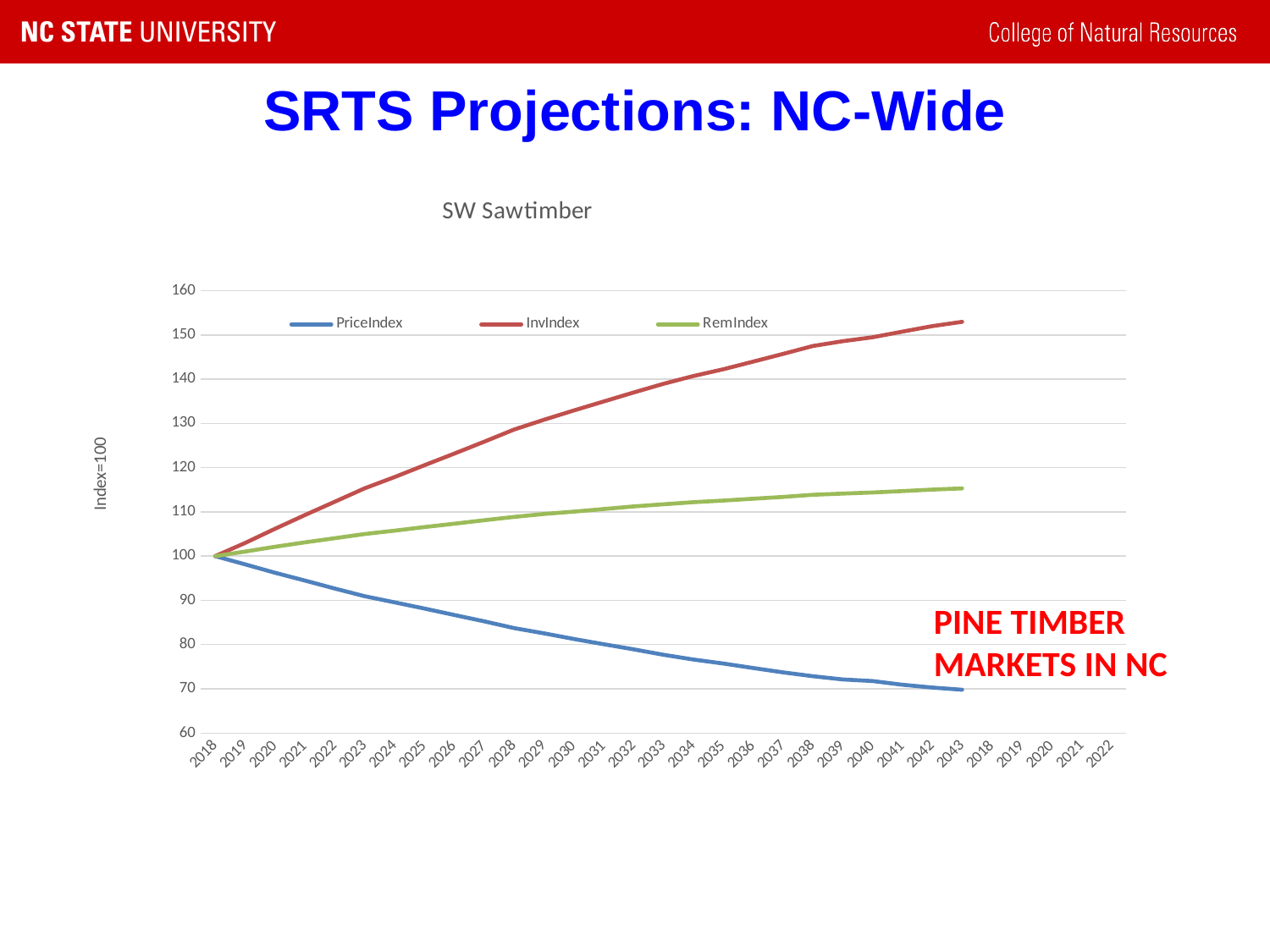
Does the PriceIndex line rise or fall from 2018 to 2043? fall Is the value for PriceIndex in 2043 greater or less than 80? less Is the value for InvIndex in 2043 greater or less than 150? greater How many series does the legend list? 3 What kind of chart is shown on the slide? line chart What is the value of PriceIndex in 2018? 100 Which series has the lowest value in 2043? PriceIndex Which series has the highest value in 2043? InvIndex What is the title of the chart? SW Sawtimber In 2043, which is larger: RemIndex or PriceIndex? RemIndex Which series is drawn in blue? PriceIndex Does the InvIndex line rise or fall from 2018 to 2043? rise